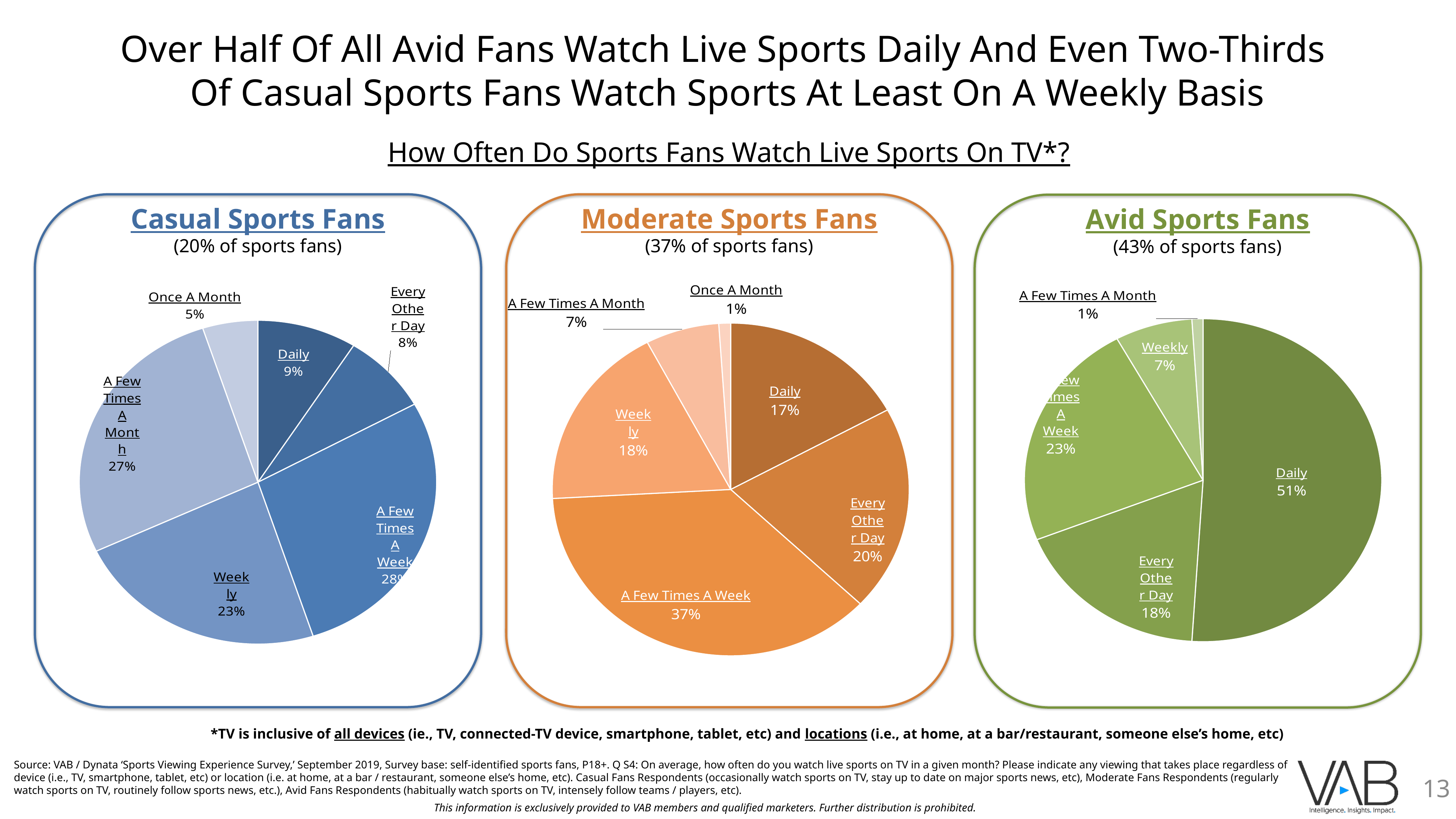
According to the subtitle of the Avid Sports Fans chart, what percentage of sports fans are avid fans? 43% In the Moderate Sports Fans chart, what is the difference between the Weekly share and the Daily share? 1% In the Avid Sports Fans chart, what share of avid fans watch live sports Daily? 51% In the Moderate Sports Fans chart, which viewing frequency has the smallest slice? Once A Month In the Casual Sports Fans chart, which is larger: the Daily slice or the A Few Times A Month slice? A Few Times A Month In the Avid Sports Fans chart, what is the difference between the Daily share and the Every Other Day share? 33% In the Casual Sports Fans chart, what percentage watch live sports Weekly? 23% In the Moderate Sports Fans chart, what percentage watch live sports A Few Times A Week? 37% What type of chart is used for the Casual Sports Fans data? Pie chart In the Moderate Sports Fans chart, which viewing frequency has the largest slice? A Few Times A Week In the Casual Sports Fans chart, what percentage watch live sports Once A Month? 5% How many slices does the Moderate Sports Fans pie chart have? 6